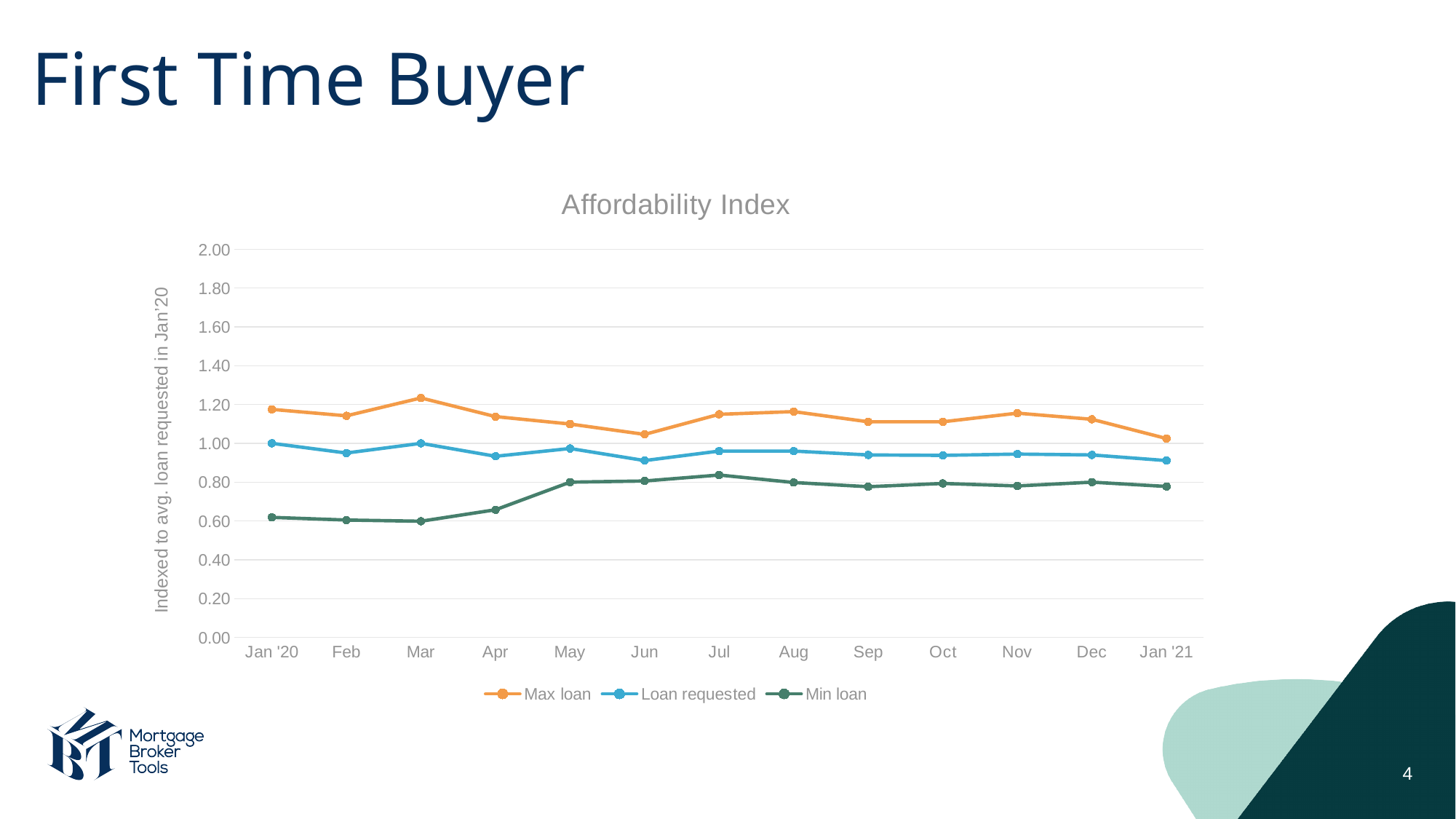
What kind of chart is shown on the slide? Line chart Is the Max loan value for Mar greater or less than 1.20? greater Does the Min loan series rise or fall between Mar and May? Rise How many series does the legend list? 3 Is the Loan requested value for Jun greater or less than 1.00? less Is the Min loan value for Jan '20 greater or less than 0.80? less How many months are plotted along the x axis? 13 What is the title of the chart? Affordability Index Which is larger in Jul, the Max loan value or the Min loan value? Max loan In which month does the Min loan series reach its highest value? Jul In which month does the Max loan series reach its highest value? Mar